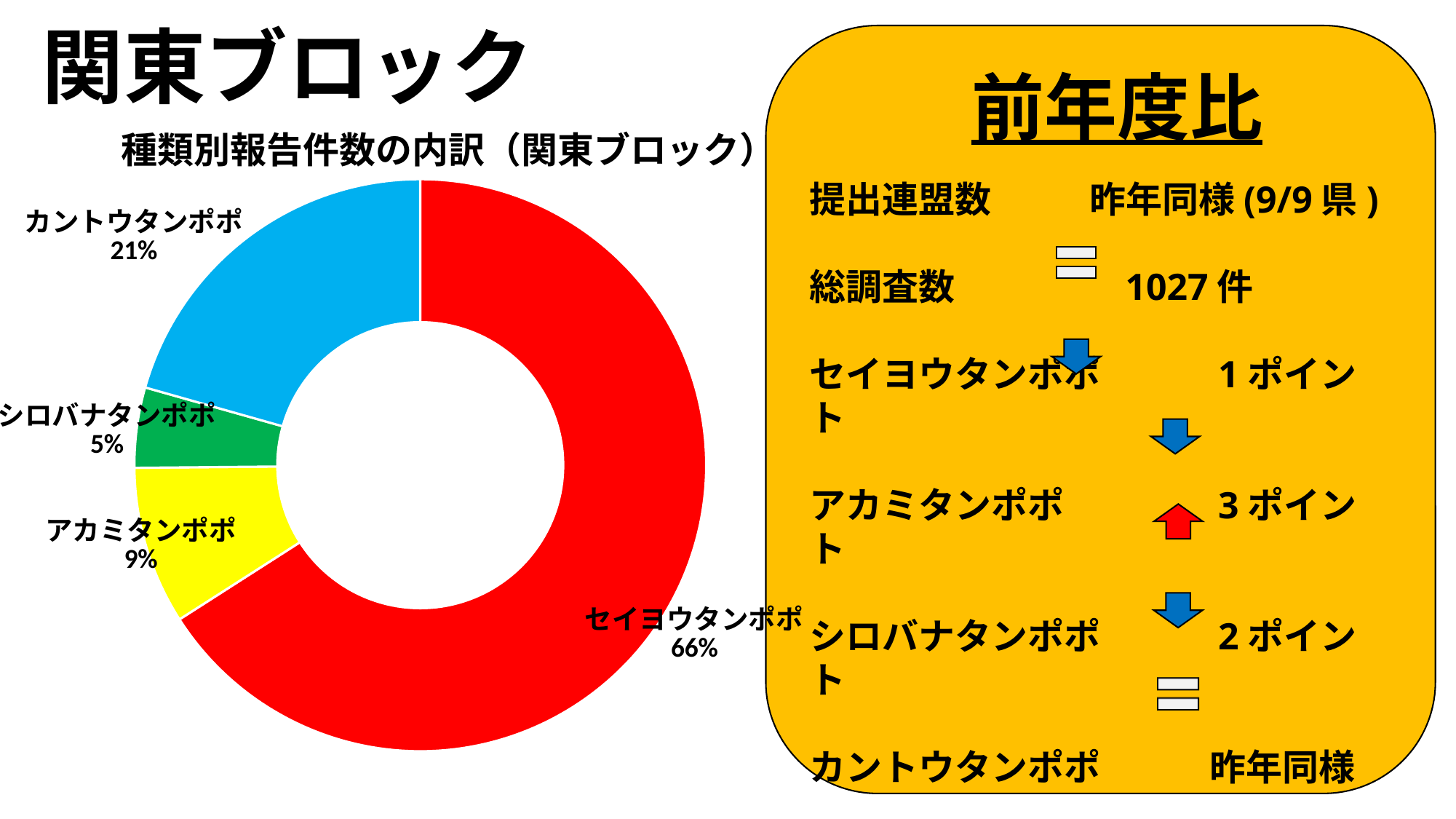
What is the difference in percentage points between セイヨウタンポポ and カントウタンポポ? 45 Which has a larger share, カントウタンポポ or アカミタンポポ? カントウタンポポ Which category has the smallest share in the chart? シロバナタンポポ What percentage is shown for カントウタンポポ in the chart? 21% What percentage is shown for アカミタンポポ in the chart? 9% What kind of chart is shown on the slide? Doughnut chart What percentage is shown for シロバナタンポポ in the chart? 5% What is the difference in percentage points between アカミタンポポ and シロバナタンポポ? 4 What share of the doughnut chart does セイヨウタンポポ account for? 66% How many categories are shown in the chart? 4 What is the title of the chart? 種類別報告件数の内訳（関東ブロック） Which category has the largest share in the chart? セイヨウタンポポ